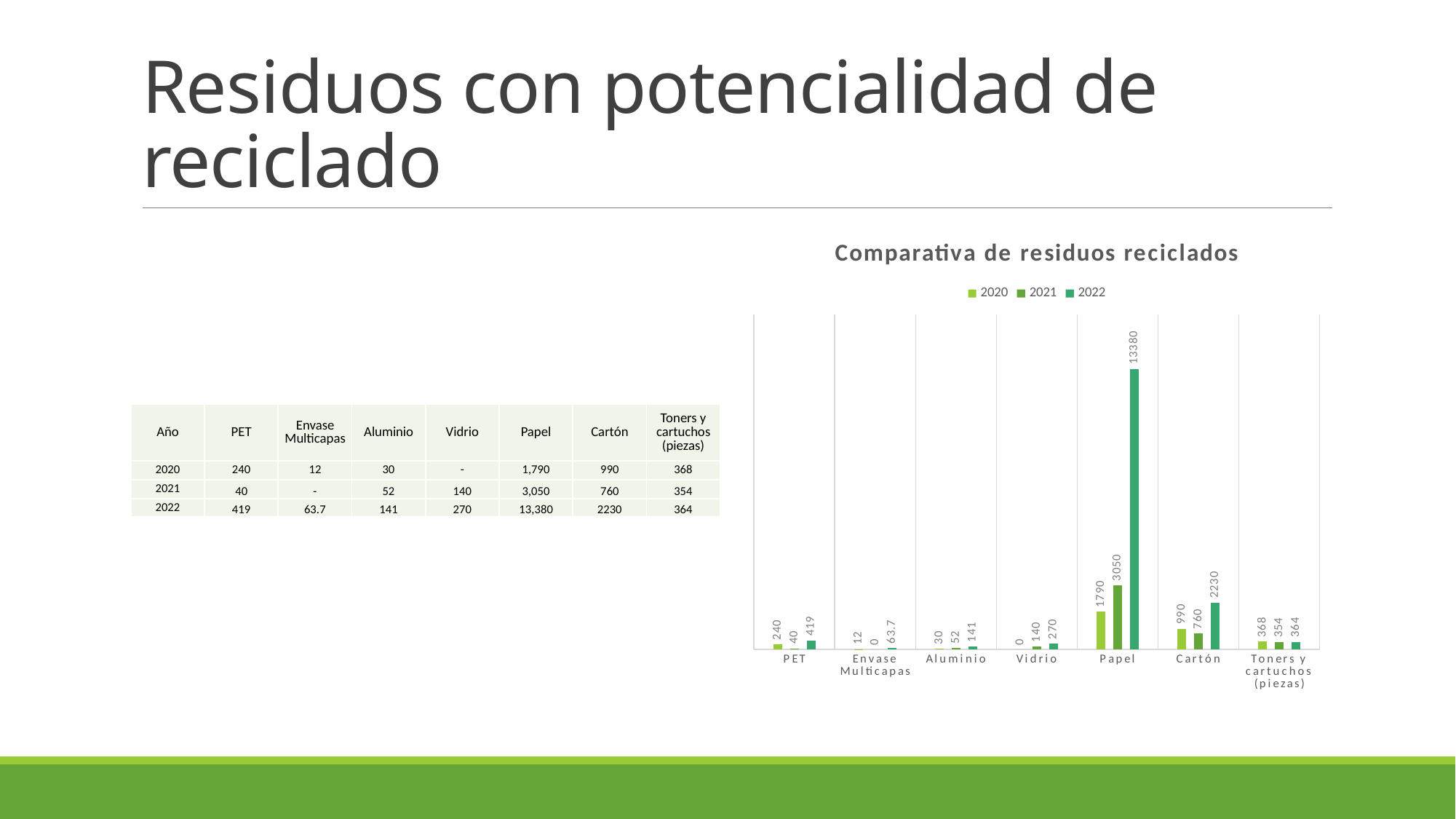
Which category has the highest value in the 2022 series? Papel What is the value for PET in the 2020 series? 240 How many series does the legend list? 3 What is the value for Vidrio in the 2021 series? 140 What is the value for Envase Multicapas in the 2022 series? 63.7 What is the title of the chart? Comparativa de residuos reciclados Which category has the lowest value in the 2021 series? Envase Multicapas What is the value for Papel in the 2022 series? 13380 What kind of chart is shown? Bar chart What is the difference between the 2022 and 2021 values for Cartón? 1470 How many categories are shown on the x axis? 7 Which is larger for Cartón: the 2020 value or the 2021 value? 2020